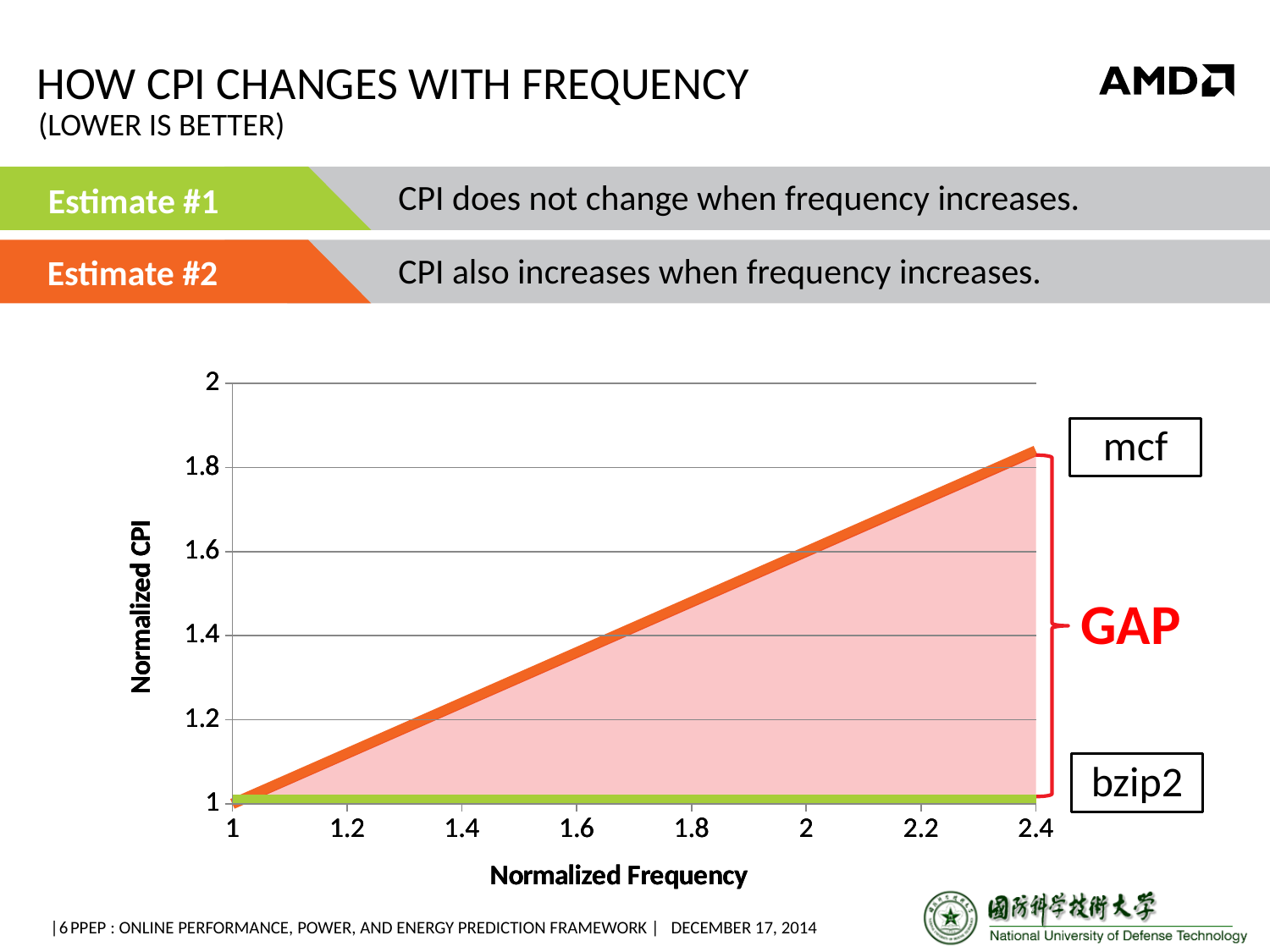
What is the title of the y axis of the chart? Normalized CPI Does the normalized CPI for mcf rise or fall as normalized frequency increases? rise At a normalized frequency of 2.4, which has the higher normalized CPI, mcf or bzip2? mcf What is the normalized CPI for mcf at a normalized frequency of 1? 1 Is the normalized CPI for mcf at a normalized frequency of 2 greater or less than 1.4? greater Is the normalized CPI for mcf at a normalized frequency of 1.4 greater or less than 1.4? less Does the normalized CPI for bzip2 rise, fall, or stay flat as normalized frequency increases? stay flat Is the normalized CPI for mcf at a normalized frequency of 2.4 greater or less than 1.8? greater How many series (lines) are plotted on the chart? 2 What kind of chart is shown on the slide? line chart What is the title of the x axis of the chart? Normalized Frequency